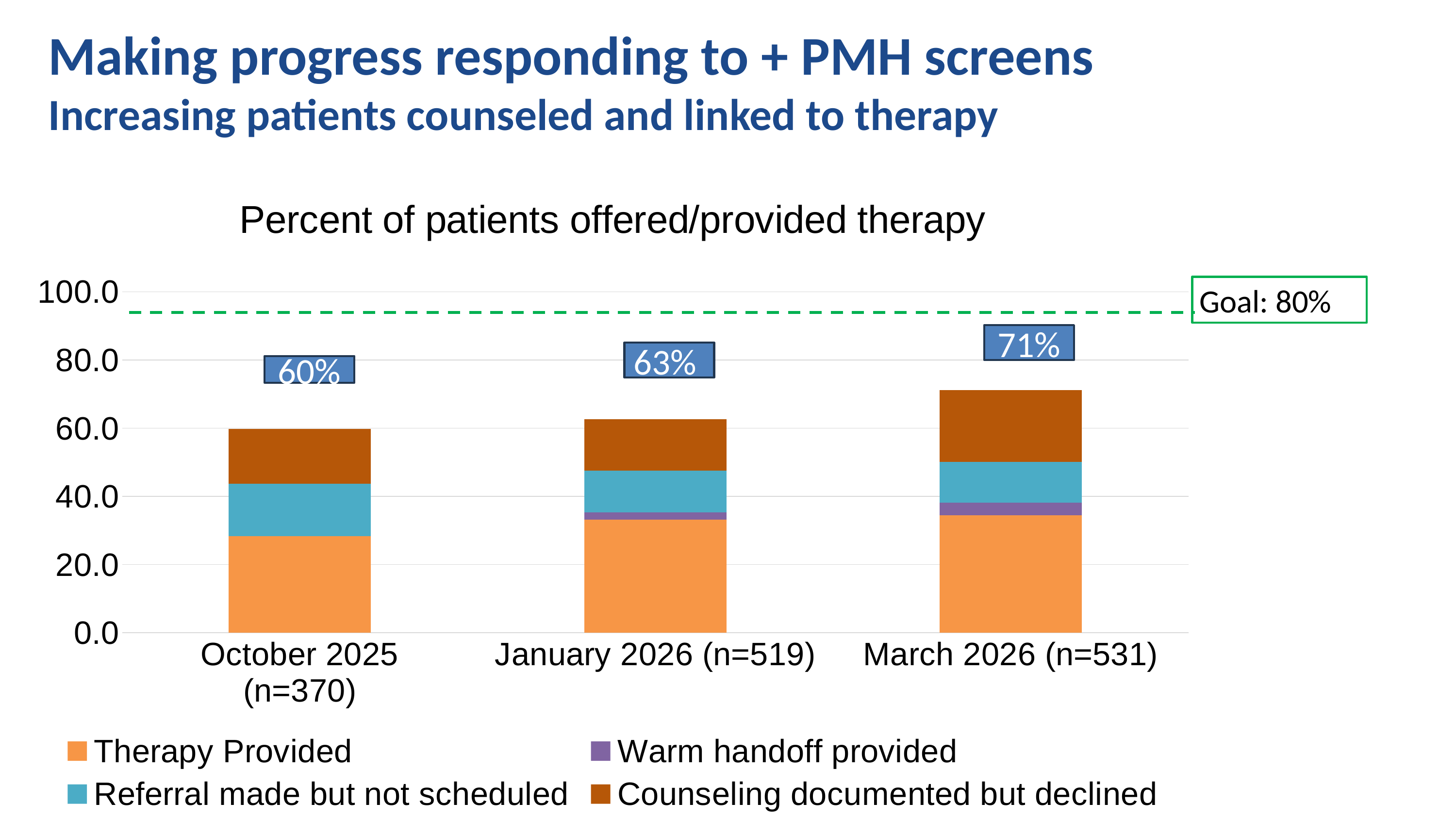
Is the total for January 2026 (n=519) larger or smaller than the total for March 2026 (n=531)? smaller What goal value is marked by the dashed line on the chart? Goal: 80% How many time periods are shown on the x axis? 3 Which time period has the highest total percent of patients offered/provided therapy? March 2026 (n=531) What kind of chart is shown on the slide? stacked bar chart What is the total percentage shown above the bar for October 2025 (n=370)? 60% What is the total percentage shown above the bar for January 2026 (n=519)? 63% Is the Therapy Provided segment for October 2025 greater or less than 40? less By how many percentage points does the March 2026 total exceed the October 2025 total? 11 How many series does the legend list? 4 What is the total percentage shown above the bar for March 2026 (n=531)? 71% Which time period has the lowest total percent of patients offered/provided therapy? October 2025 (n=370)